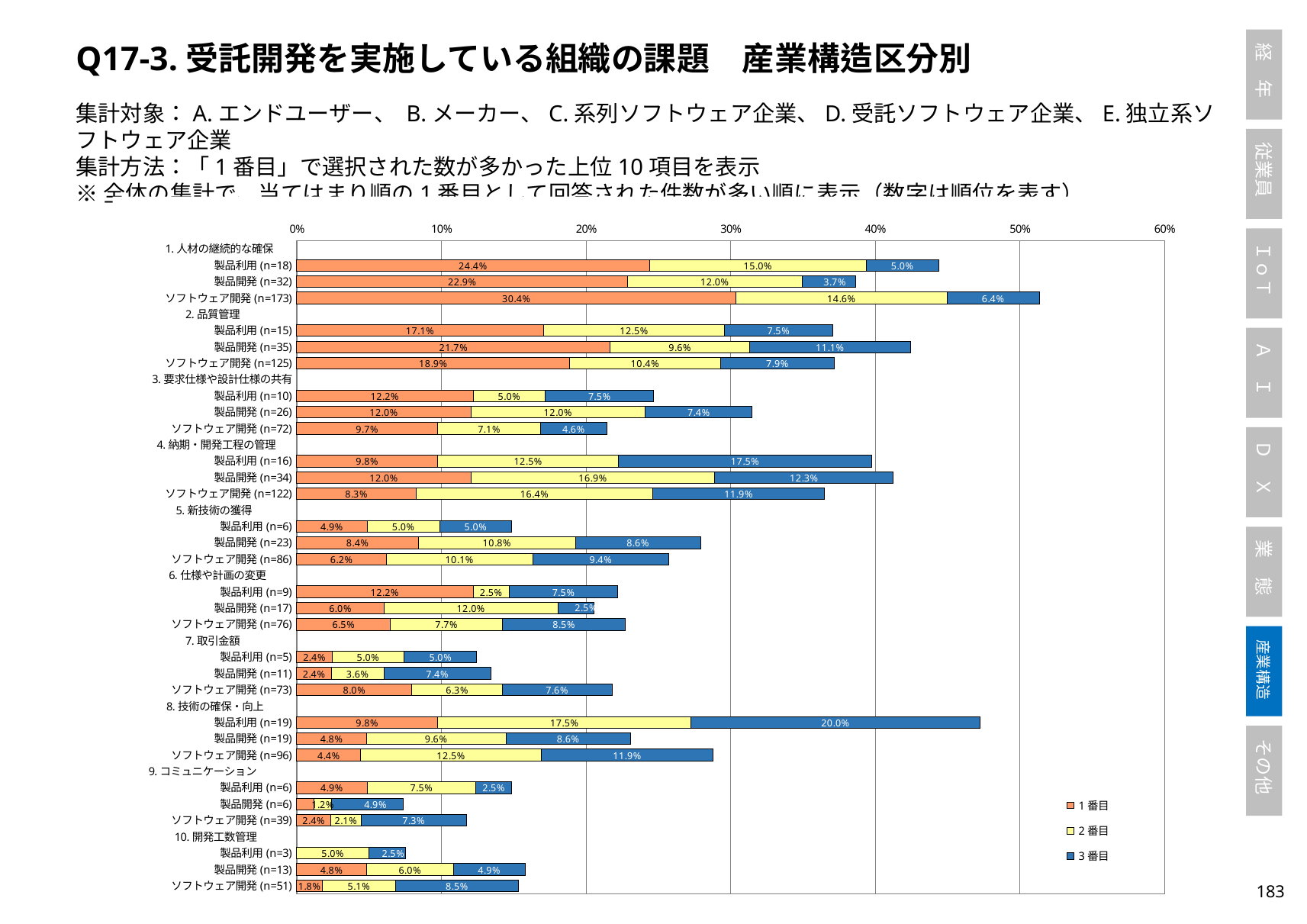
What are the three legend entries of the chart? 1番目, 2番目, 3番目 In the stacked bar chart, what is the 1番目 value for ソフトウェア開発 (n=173) under 1. 人材の継続的な確保? 30.4% What is the total of the stacked bar for 製品利用 (n=16) under 4. 納期・開発工程の管理? 39.8% In the stacked bar chart, what is the 1番目 value for 製品利用 (n=5) under 7. 取引金額? 2.4% For 製品開発 (n=35) under 2. 品質管理, how much larger is the 1番目 value than the 2番目 value? 12.1 percentage points Is the total length of the stacked bar for 製品利用 (n=19) under 8. 技術の確保・向上 greater or less than 50%? less How many series does the legend list? 3 In the stacked bar chart, what is the 3番目 value for 製品利用 (n=19) under 8. 技術の確保・向上? 20.0% What is the total of the stacked bar for 製品利用 (n=18) under 1. 人材の継続的な確保? 44.4% Which bar has the highest 1番目 value in the chart? ソフトウェア開発 (n=173) under 1. 人材の継続的な確保 What kind of chart is shown on the slide? Stacked bar chart Under 2. 品質管理, which has the larger 3番目 value: 製品利用 (n=15) or 製品開発 (n=35)? 製品開発 (n=35)